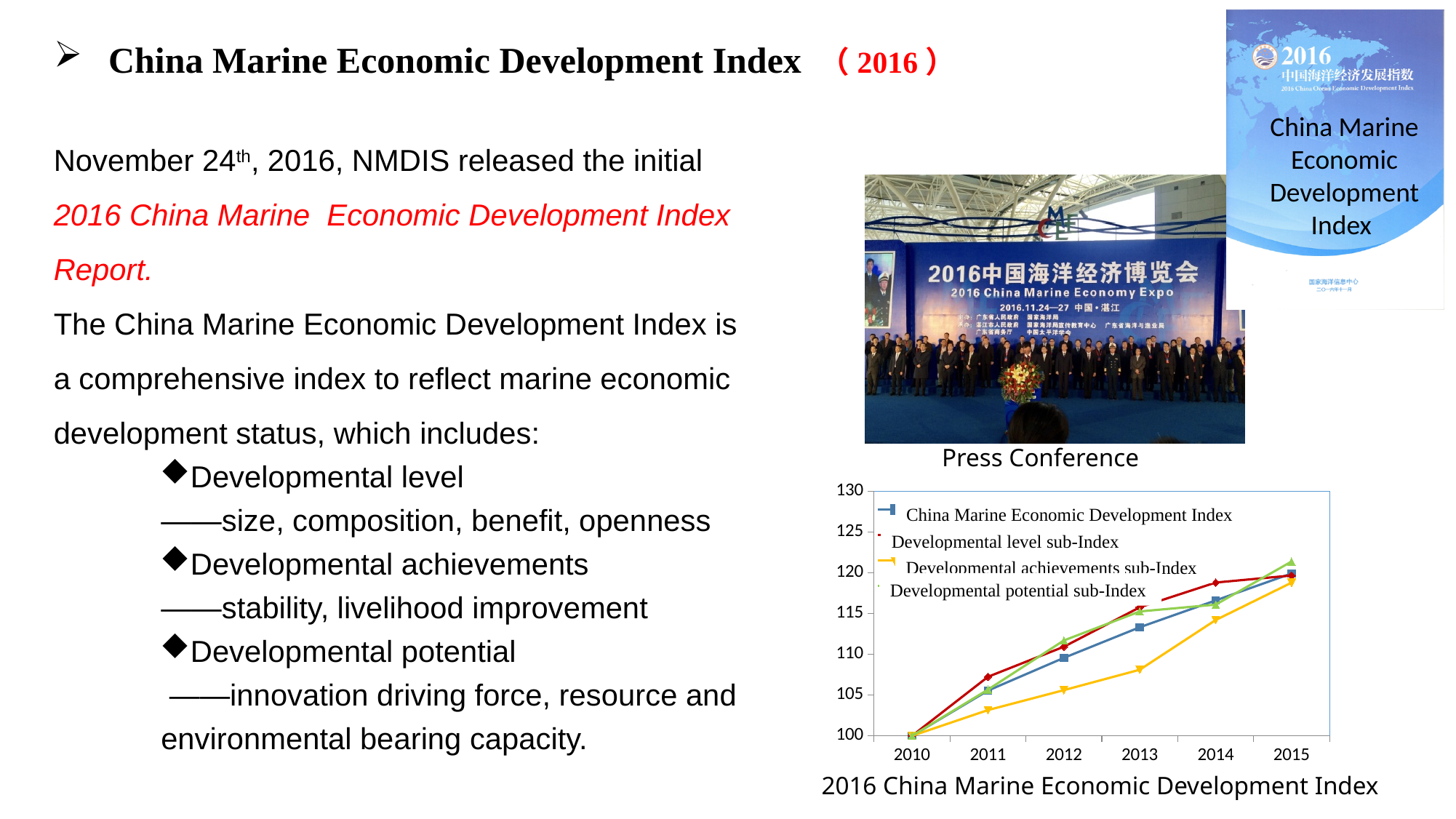
Is the value of the Developmental achievements sub-Index in 2013 greater or less than 110? less In 2012, which is larger: the Developmental level sub-Index or the Developmental achievements sub-Index? Developmental level sub-Index What is the value of the Developmental achievements sub-Index in 2010? 100 How many series does the chart's legend list? 4 What kind of chart is shown on the slide? line chart Is the value of the Developmental achievements sub-Index in 2011 greater or less than 105? less Which series has the lowest value in 2013? Developmental achievements sub-Index What is the value of the China Marine Economic Development Index in 2010? 100 How many years are shown along the x axis of the chart? 6 Do the values of the China Marine Economic Development Index rise or fall from 2010 to 2015? rise What is the title shown below the chart? 2016 China Marine Economic Development Index Is the value of the Developmental level sub-Index in 2014 greater or less than 115? greater